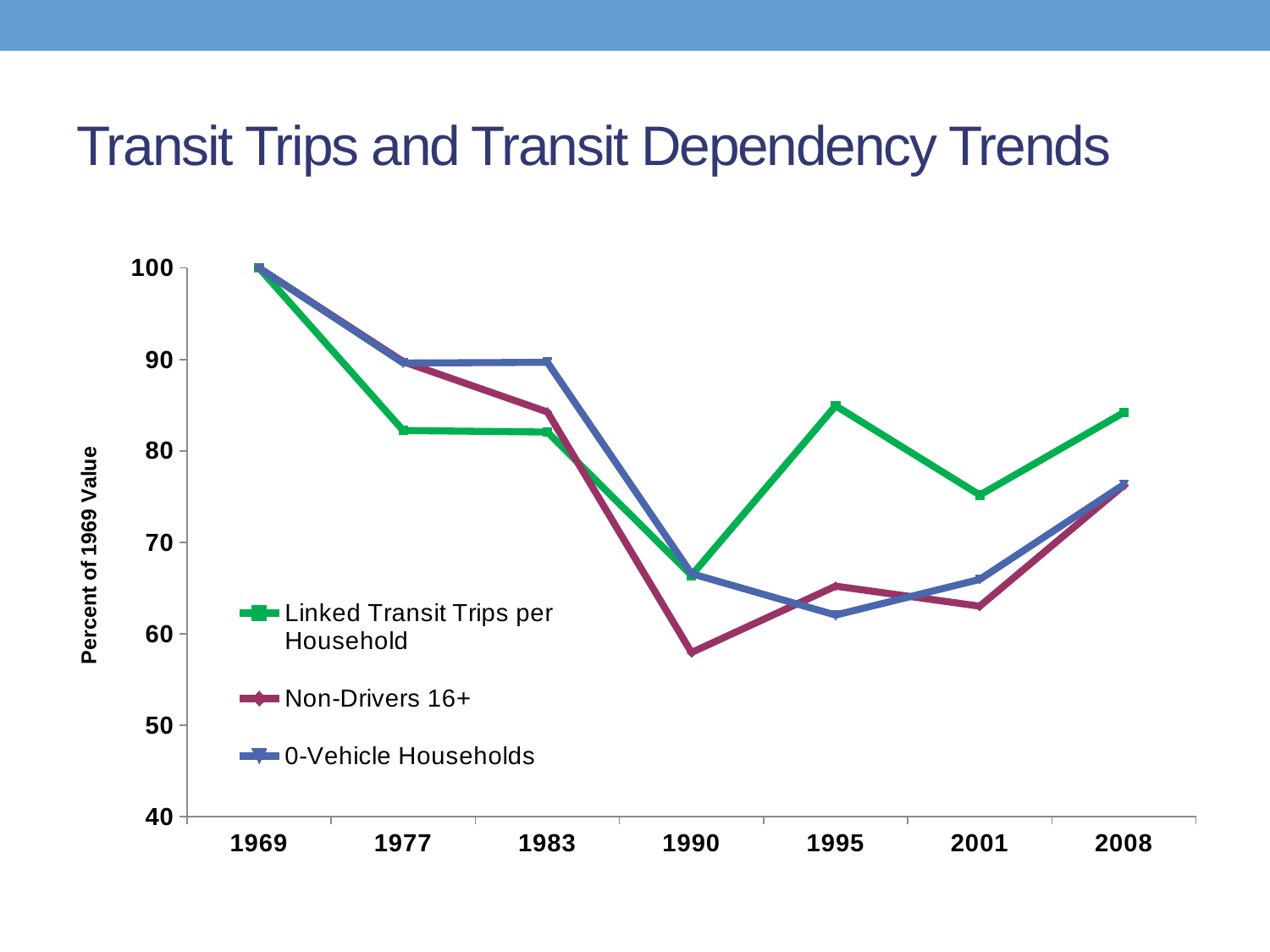
What is the label on the y axis? Percent of 1969 Value How many years are plotted along the x axis? 7 What kind of chart is shown on the slide? line chart Does the Linked Transit Trips per Household series rise or fall from 1969 to 1990? fall What is the value for Linked Transit Trips per Household in 1969? 100 In which year is the 0-Vehicle Households series at its lowest? 1995 Is the value for Linked Transit Trips per Household in 1995 greater or less than 80? greater In 1995, which series has the higher value: Linked Transit Trips per Household or Non-Drivers 16+? Linked Transit Trips per Household Is the value for 0-Vehicle Households in 1995 greater or less than 70? less In which year is the Non-Drivers 16+ series at its lowest? 1990 How many series does the legend list? 3 Is the value for Non-Drivers 16+ in 1990 greater or less than 60? less